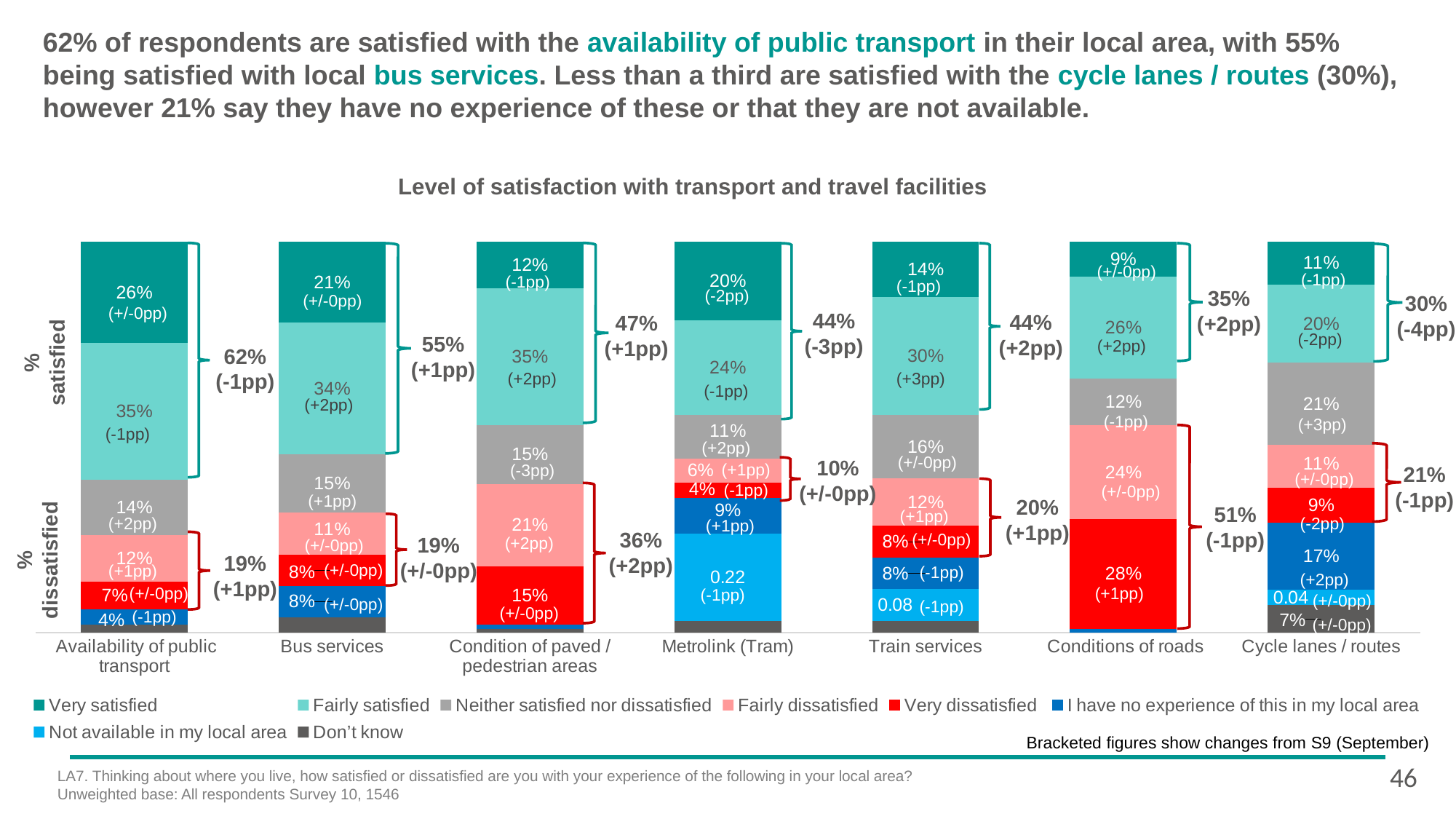
Which is larger: the very satisfied value for Metrolink (Tram) or for Train services? Metrolink (Tram) How many series does the legend list? 8 What is the fairly satisfied value for Condition of paved / pedestrian areas? 35% What is the total dissatisfied share shown for Conditions of roads? 51% What is the very dissatisfied value for Conditions of roads? 28% What percentage of respondents are very satisfied with the availability of public transport? 26% How many categories (transport facilities) are shown on the x axis? 7 What is the difference between the fairly satisfied values for Bus services and Train services? 4% Which category has the lowest overall satisfied total (bracketed % satisfied)? Cycle lanes / routes Which category has the highest very dissatisfied value? Conditions of roads What is the title of the chart? Level of satisfaction with transport and travel facilities What kind of chart is shown on the slide? Stacked bar chart